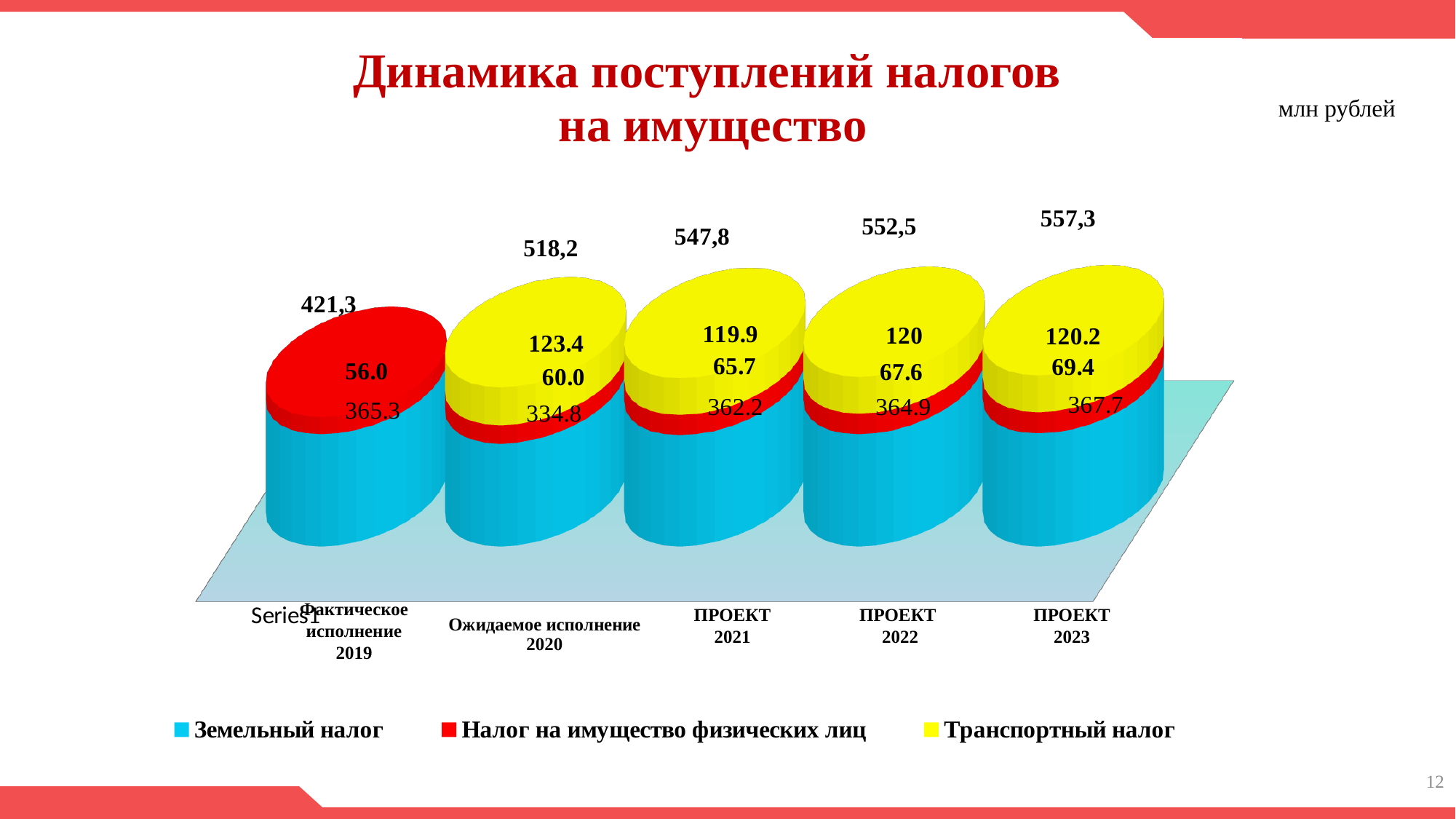
Which is larger: Транспортный налог for Ожидаемое исполнение 2020 or for ПРОЕКТ 2022? Ожидаемое исполнение 2020 What kind of chart is shown on the slide? Stacked bar chart What is the value of Земельный налог for ПРОЕКТ 2021? 362.2 How many series does the legend list? 3 What is the value of Налог на имущество физических лиц for Фактическое исполнение 2019? 56.0 How many categories are shown along the x axis? 5 What is the difference between the Земельный налог values for ПРОЕКТ 2023 and Ожидаемое исполнение 2020? 32.9 Which category has the highest value for Налог на имущество физических лиц? ПРОЕКТ 2023 What is the total printed above the bar for ПРОЕКТ 2023? 557,3 Do the totals rise or fall from Фактическое исполнение 2019 to ПРОЕКТ 2023? Rise What is the value of Транспортный налог for Ожидаемое исполнение 2020? 123.4 Which category has the lowest total? Фактическое исполнение 2019